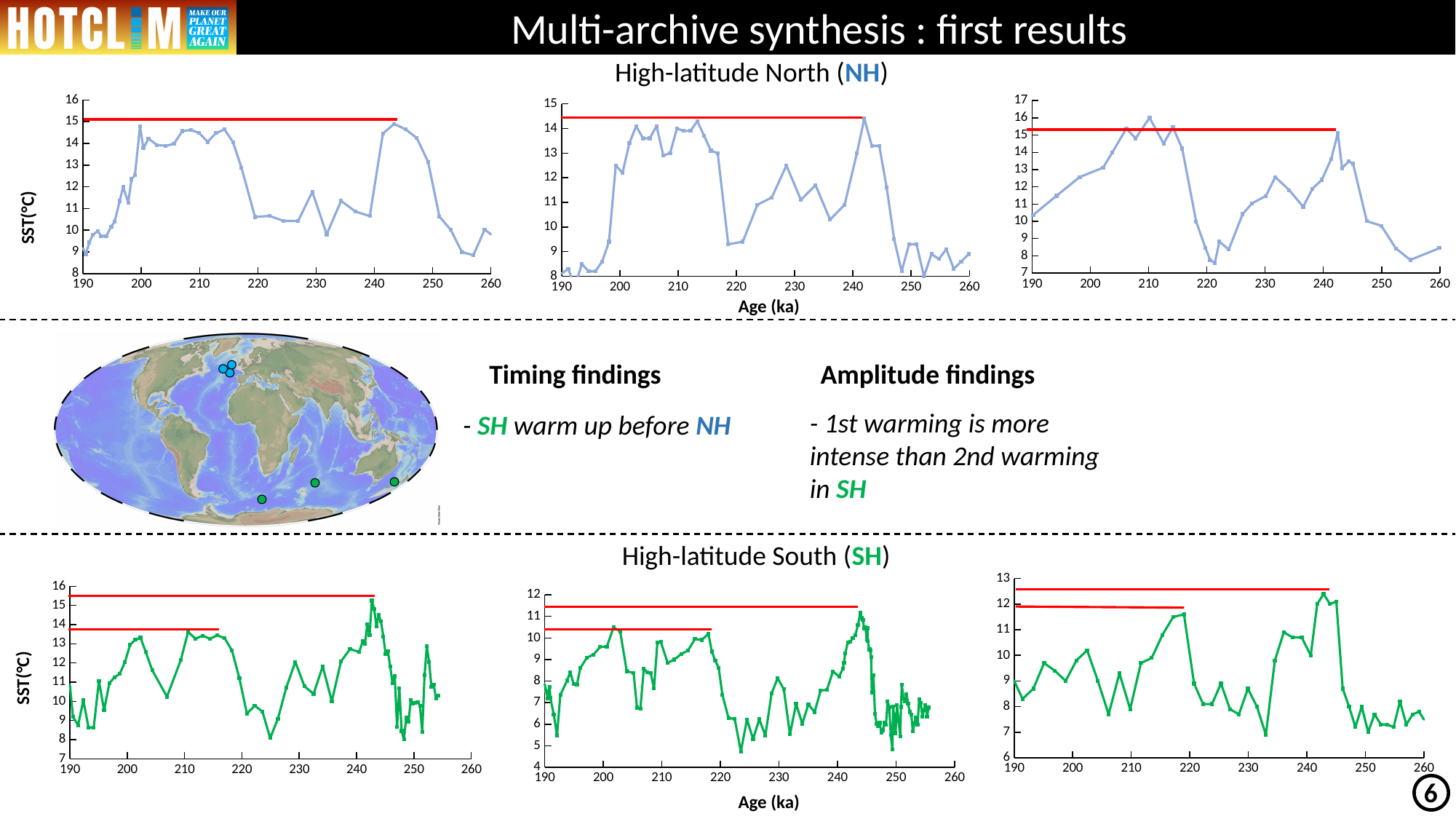
How many line charts are shown on the slide in total? 6 In the top-right NH chart, is the SST value at 210 ka greater or less than 15? greater In the top-middle NH chart, is the SST value at 210 ka greater or less than 12? greater In the bottom-left SH chart, is the SST value at 225 ka greater or less than 9? less In the bottom-right SH chart, does the SST rise or fall between 245 ka and 260 ka? fall What is the y-axis label on the left-hand charts? SST(°C) In the top-right NH chart, does the SST rise or fall between 190 ka and 210 ka? rise What kind of chart is the top-left High-latitude North (NH) chart? line chart What is the x-axis label shared by the charts on the slide? Age (ka)